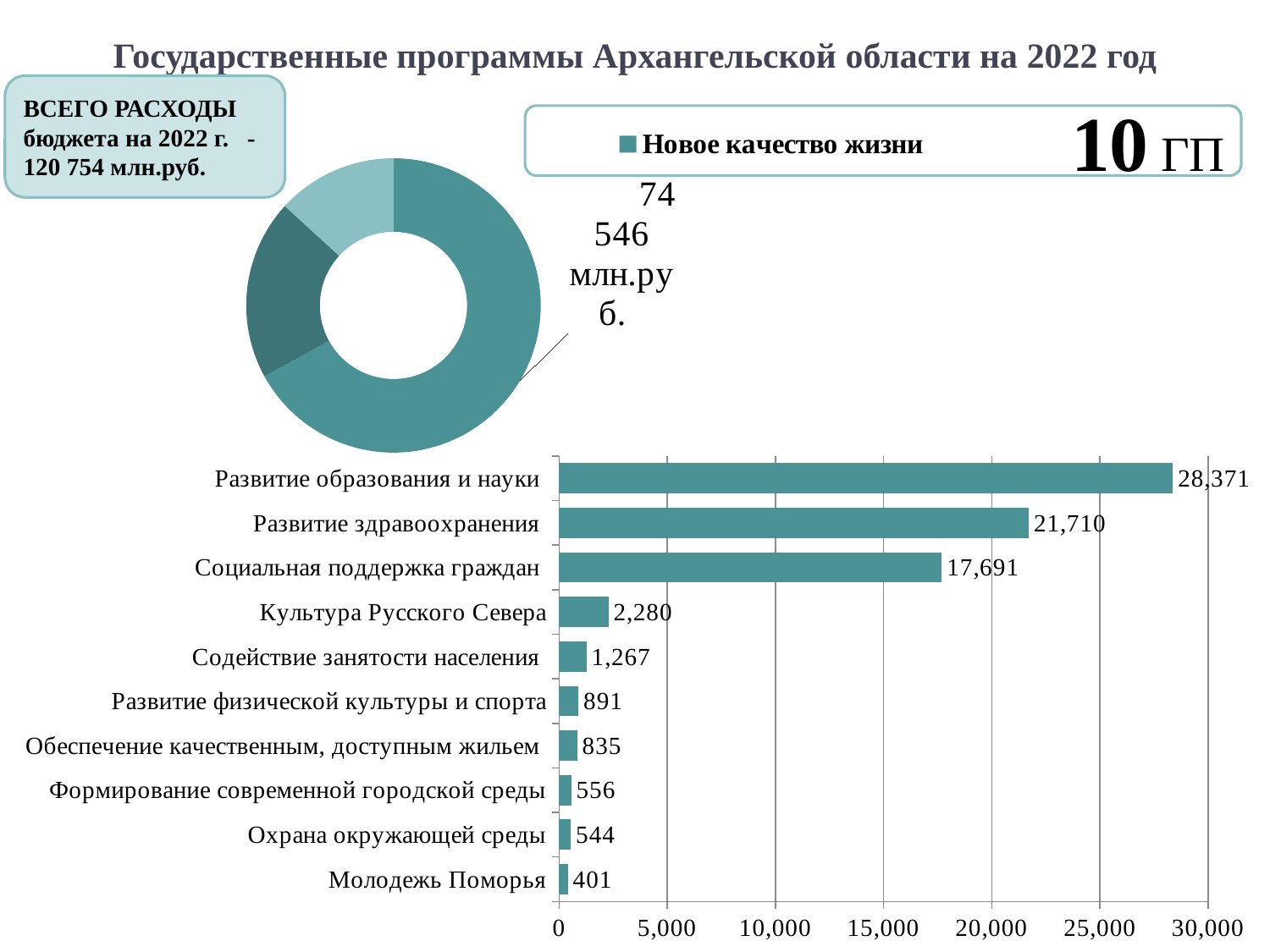
In the bar chart, what is the difference between Развитие физической культуры и спорта and Обеспечение качественным, доступным жильем? 56 In the bar chart, which category has the lowest value? Молодежь Поморья In the donut chart, what value is labelled for Новое качество жизни? 74 546 млн.руб. In the bar chart, which is larger: Культура Русского Севера or Содействие занятости населения? Культура Русского Севера In the bar chart, what is the value for Развитие образования и науки? 28,371 In the bar chart, what is the value for Охрана окружающей среды? 544 In the bar chart, what is the value for Социальная поддержка граждан? 17,691 In the bar chart, which category has the highest value? Развитие образования и науки In the bar chart, is the value for Развитие здравоохранения greater or less than 20,000? greater What kind of chart is the lower chart on the slide? bar chart In the bar chart, what is the difference between Развитие образования и науки and Развитие здравоохранения? 6,661 How many categories are shown in the bar chart? 10